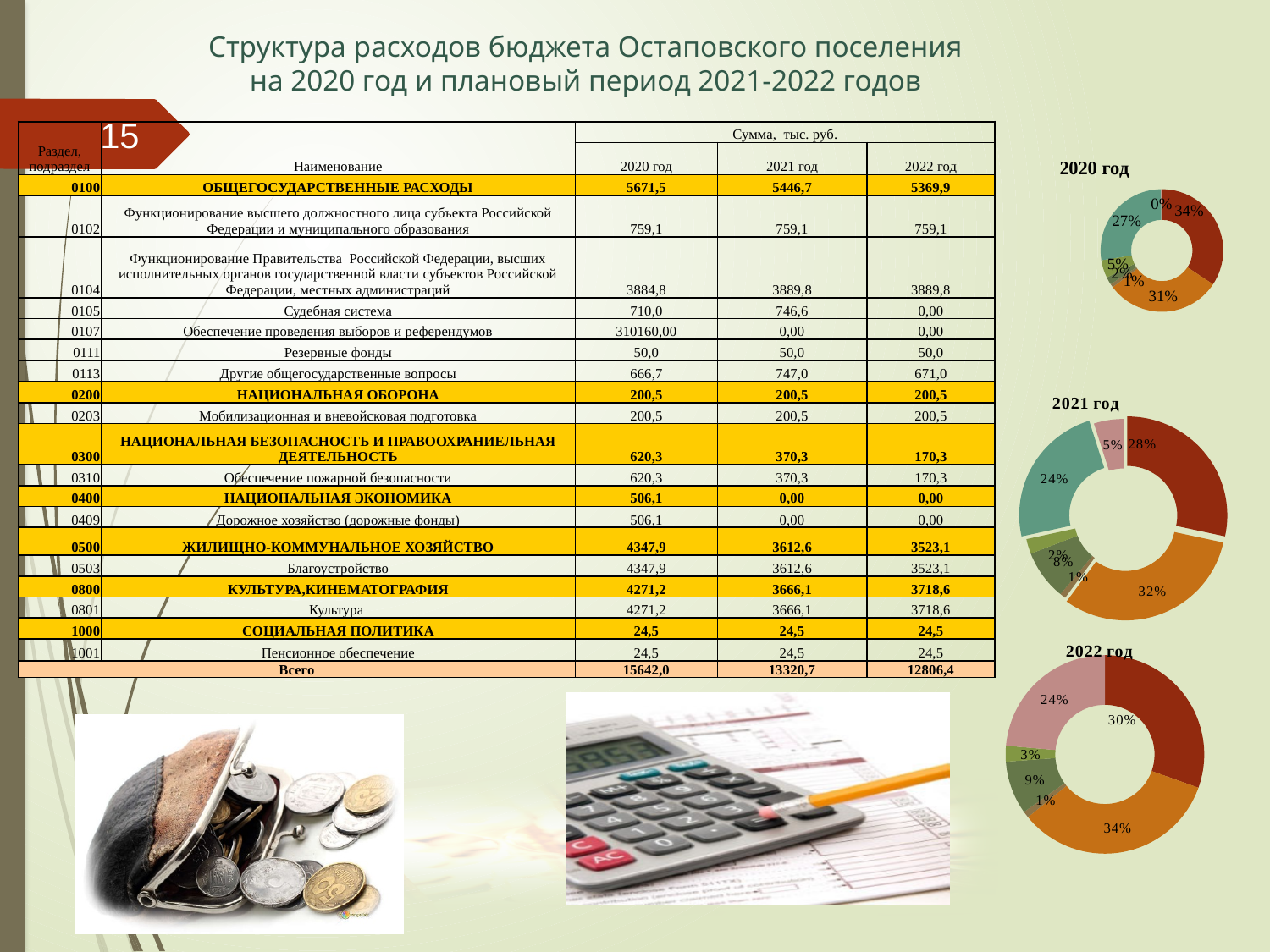
In the chart titled "2021 год", what is the share of the largest slice? 32% In the chart titled "2020 год", what is the share of the second-largest slice? 31% How many doughnut charts are shown on the slide? 3 What is the title of the bottom chart on the slide? 2022 год In the chart titled "2022 год", what is the share of the largest slice? 34% What kind of chart is the chart titled "2020 год"? doughnut chart In the chart titled "2022 год", what is the share of the smallest slice? 1% In the chart titled "2021 год", how many slices are there? 7 In the chart titled "2021 год", which is larger: the slice labelled 28% or the slice labelled 24%? 28% In the chart titled "2022 год", what is the difference in percentage points between the largest slice (34%) and the second-largest slice (30%)? 4 percentage points In the chart titled "2020 год", what is the share of the largest slice? 34% In the chart titled "2022 год", how many slices are there? 6